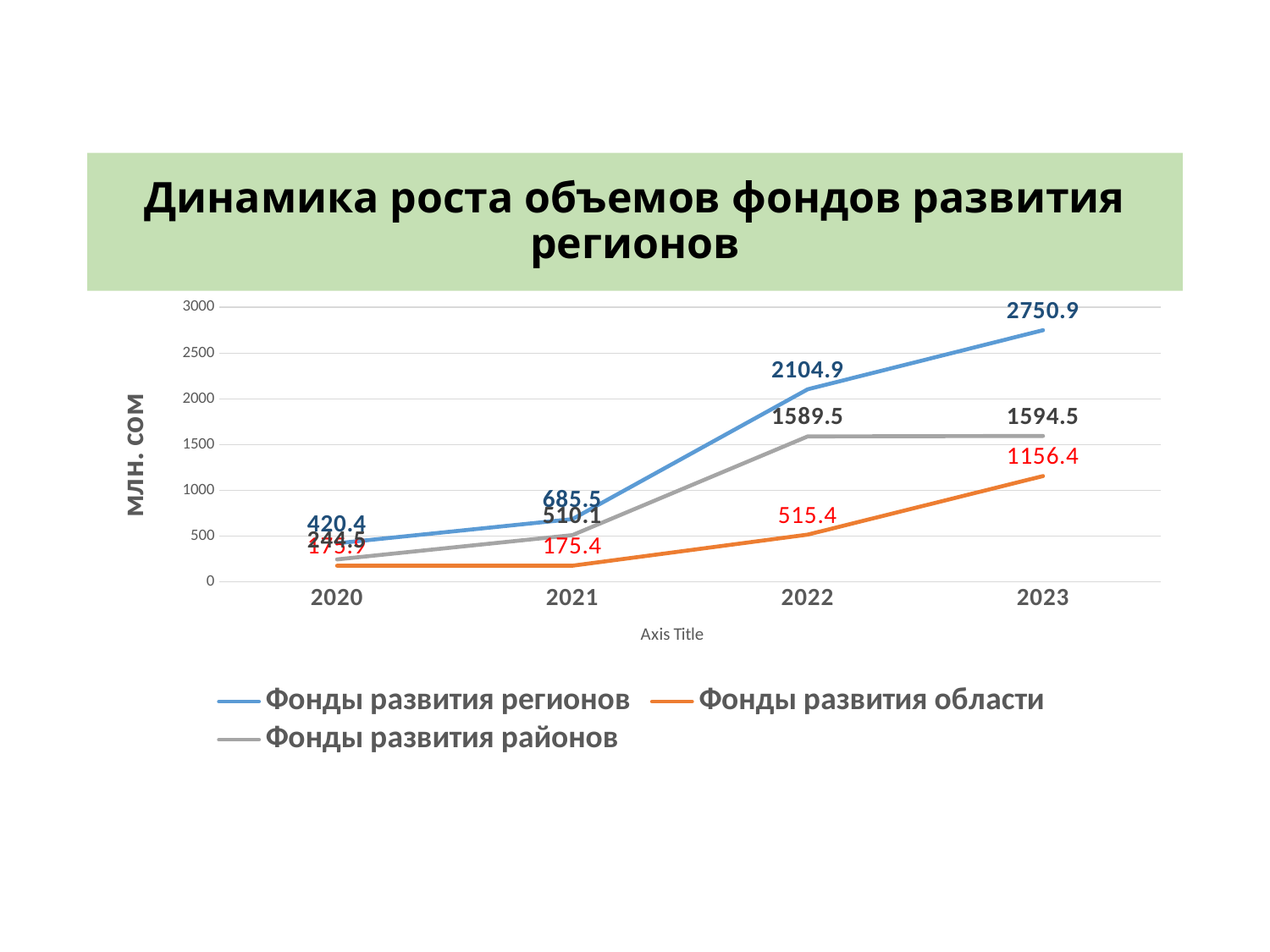
What is the value for Фонды развития области in 2021? 175.4 How many years are shown on the x axis? 4 Which series has the lowest value in 2022? Фонды развития области Does Фонды развития области rise or fall from 2021 to 2023? rise What is the difference between Фонды развития регионов in 2023 and 2022? 646.0 What is the value for Фонды развития регионов in 2023? 2750.9 What type of chart is shown on the slide? line chart What is the value for Фонды развития районов in 2022? 1589.5 How many series does the legend list? 3 What is the value for Фонды развития регионов in 2021? 685.5 Which is larger in 2023: Фонды развития районов or Фонды развития области? Фонды развития районов In which year is Фонды развития регионов highest? 2023